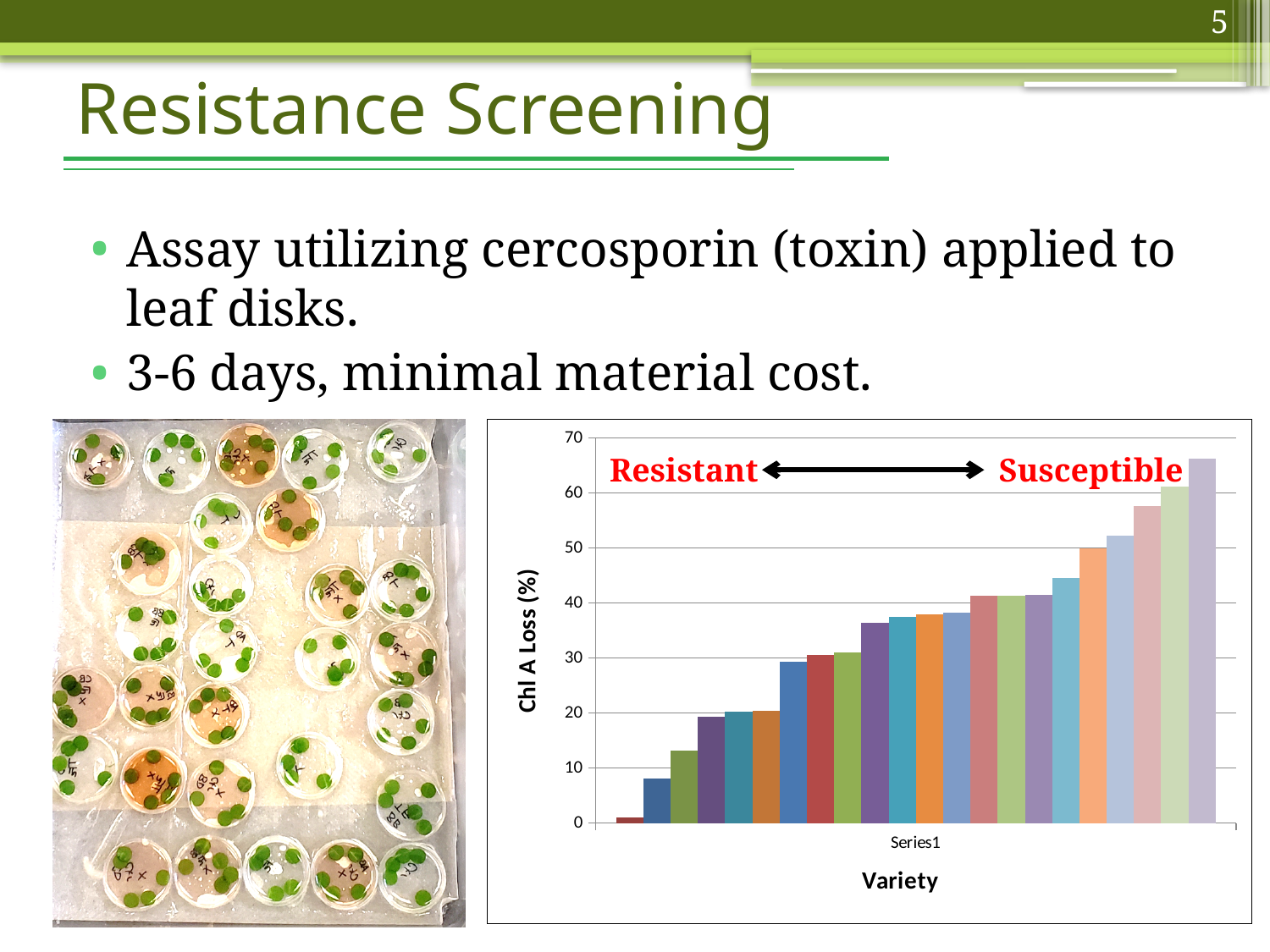
How many bars are plotted in the chart? 22 What is the title of the vertical axis of the chart? Chl A Loss (%) Which bar is taller, the leftmost bar or the rightmost bar? the rightmost bar Is the value of the shortest (leftmost) bar greater or less than 10? less What is the title of the horizontal axis of the chart? Variety Is the value of the tallest (rightmost) bar greater or less than 60? greater What is the highest tick value shown on the vertical axis? 70 What kind of chart is shown on the slide? bar chart Do the bar values rise or fall from left to right along the x axis? rise Is the value of the second bar from the left greater or less than 10? less